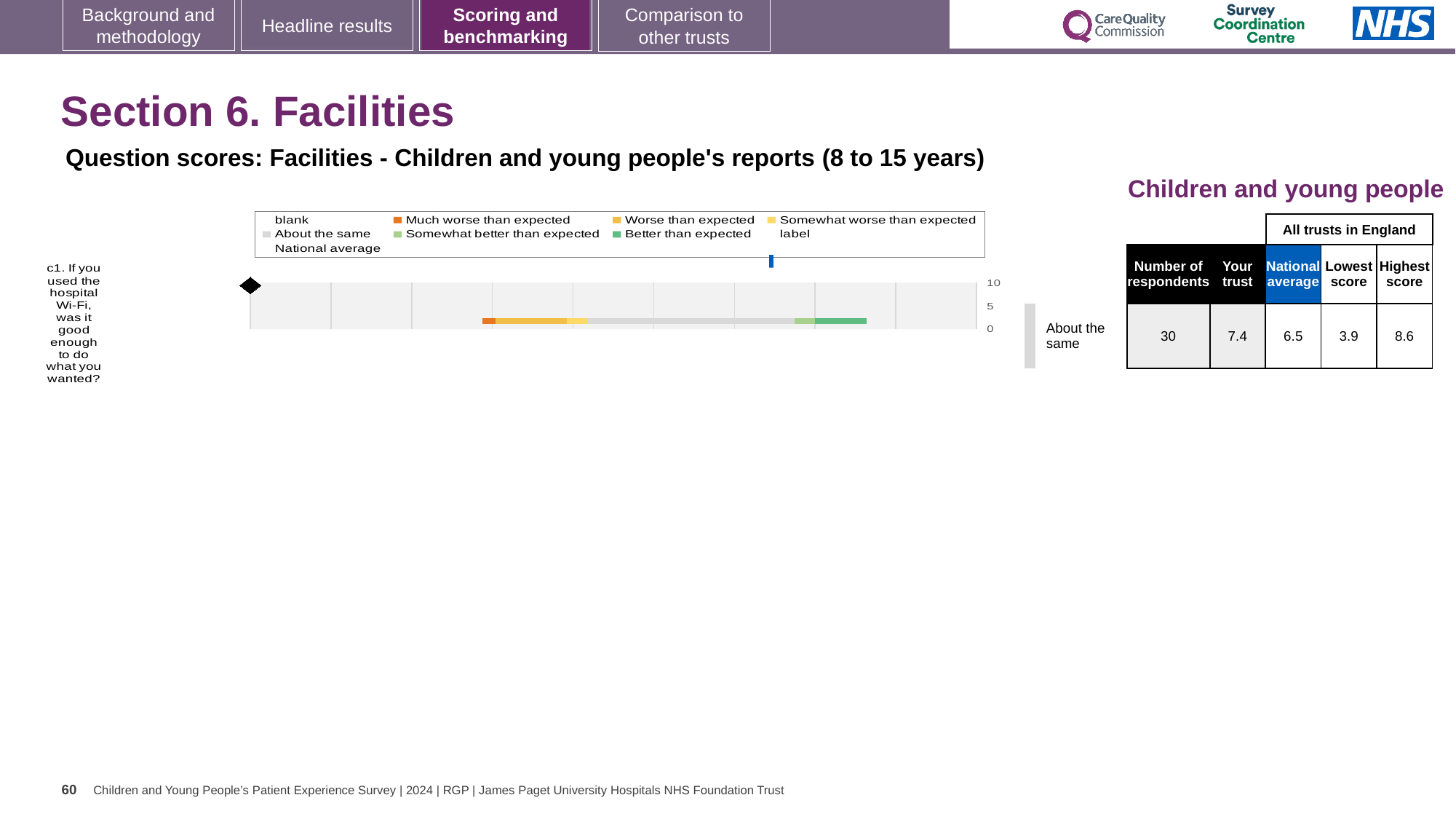
What is the lowest score among all trusts in England for question c1? 3.9 For question c1, which is larger: the 'Your trust' score or the national average? Your trust What is the highest value shown on the chart's numeric axis? 10 How many survey questions are plotted in the chart? 1 What is the highest score among all trusts in England for question c1? 8.6 What is the national average score for question c1 (hospital Wi-Fi)? 6.5 What kind of chart is shown on the slide for question c1? Bar chart By how much does the 'Your trust' score (7.4) exceed the national average (6.5) for question c1? 0.9 What is the difference between the highest score (8.6) and the lowest score (3.9) for question c1? 4.7 What is the 'Your trust' score for question c1 (hospital Wi-Fi)? 7.4 What benchmark category is assigned to question c1 on the slide? About the same According to the table next to the chart, how many respondents answered question c1 about the hospital Wi-Fi? 30